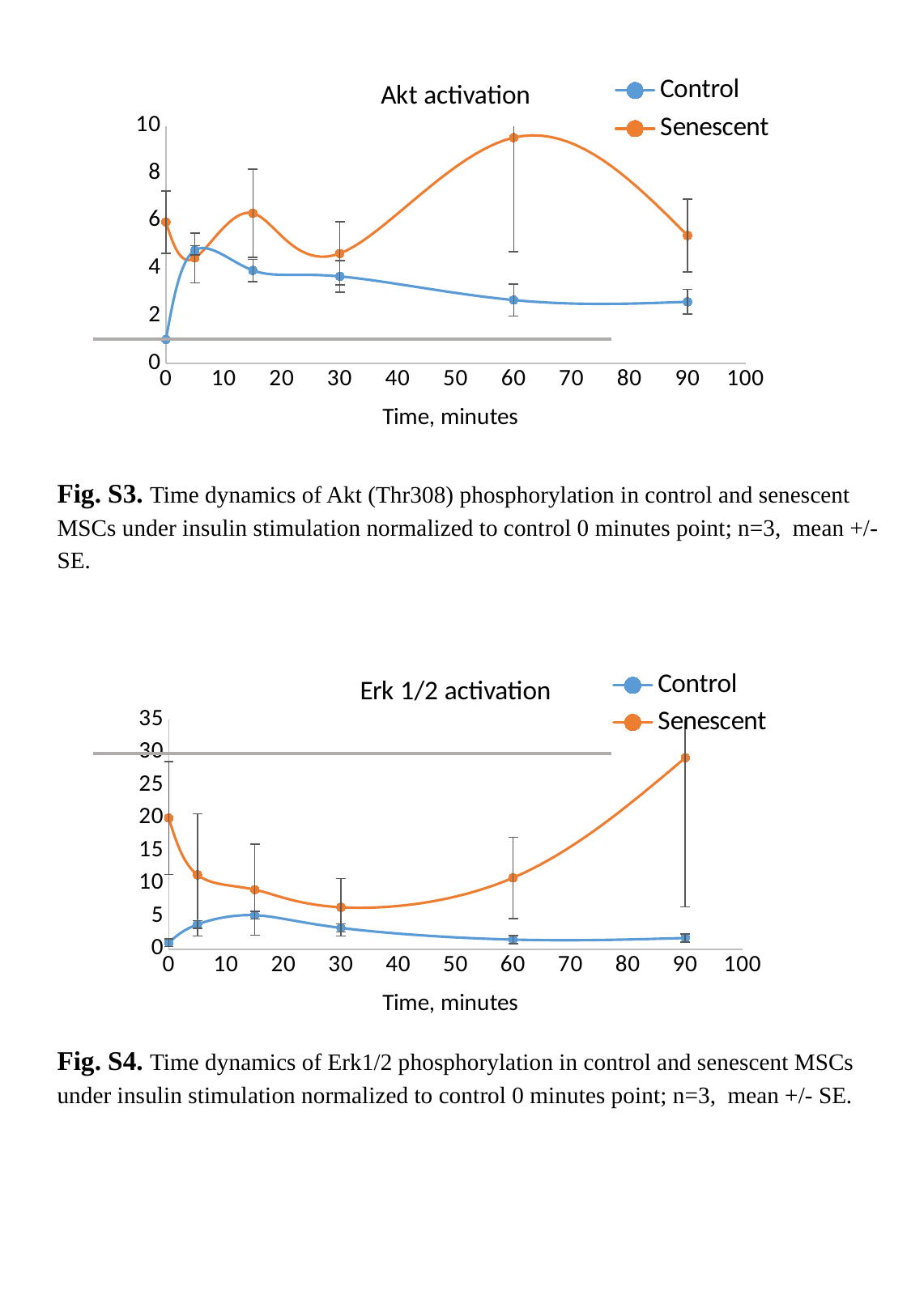
How many time points are plotted for each series in the "Akt activation" chart? 6 In the "Akt activation" chart, is the Senescent value at 60 minutes greater or less than 8? greater What is the x-axis title of the "Erk 1/2 activation" chart? Time, minutes In the "Akt activation" chart, is the Control value at 90 minutes greater or less than 4? less In the "Akt activation" chart, which series has the larger value at 60 minutes, Control or Senescent? Senescent How many series does the legend of the "Akt activation" chart list? 2 In the "Erk 1/2 activation" chart, is the Control value at 90 minutes greater or less than 5? less In the "Erk 1/2 activation" chart, which series has the larger value at 0 minutes, Control or Senescent? Senescent In the "Akt activation" chart, at which time point does the Senescent series reach its highest value? 60 minutes In the "Erk 1/2 activation" chart, at which time point does the Senescent series reach its highest value? 90 minutes What kind of chart is the "Akt activation" chart? line chart